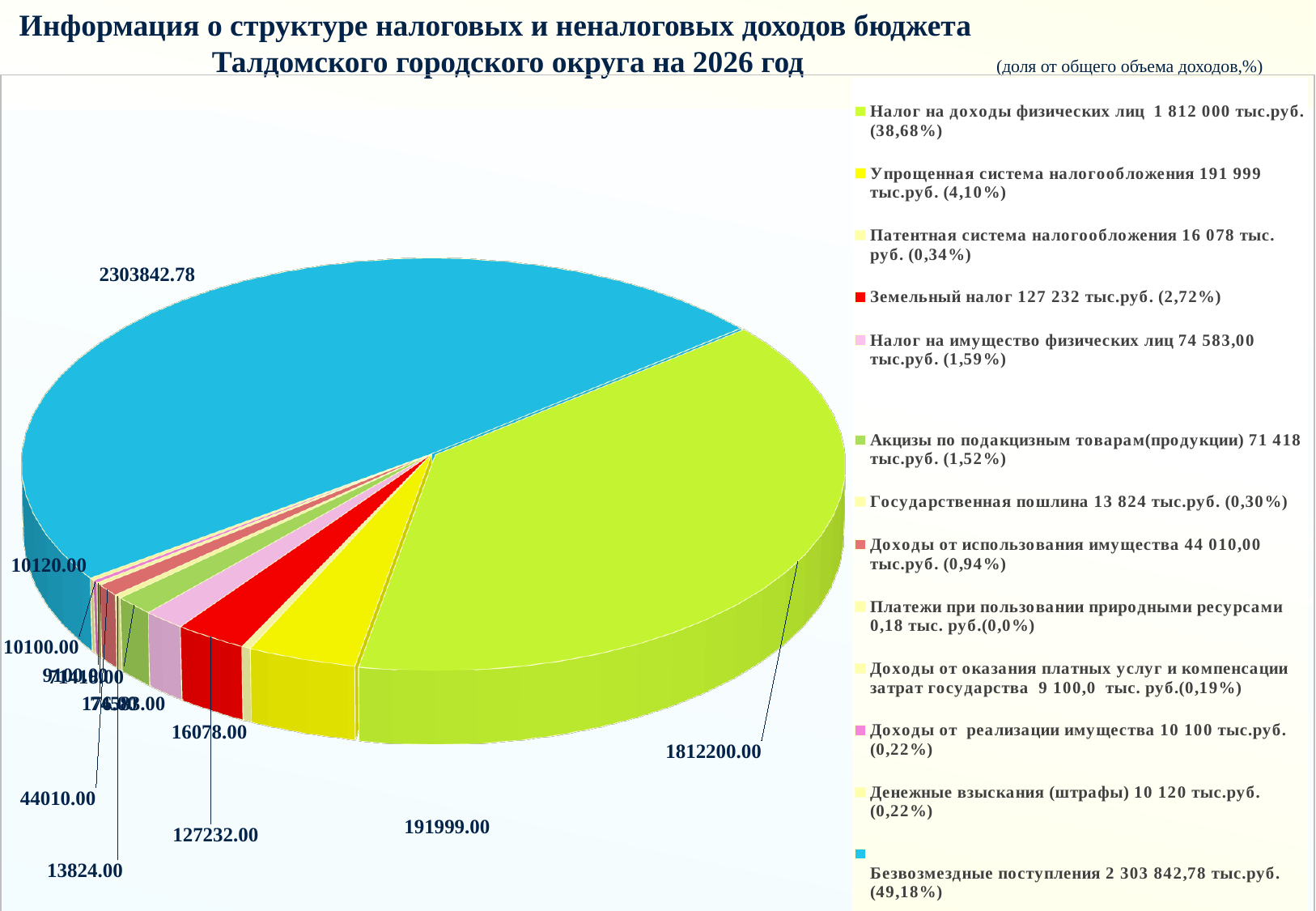
Which category has the largest share of the pie? Безвозмездные поступления Which category has the smallest share according to the legend? Платежи при пользовании природными ресурсами What share of total revenue does Налог на доходы физических лиц represent, according to the legend? 38,68% Which is larger: the slice for Упрощенная система налогообложения or the slice for Земельный налог? Упрощенная система налогообложения What is the data label shown on the slice for Упрощенная система налогообложения? 191999.00 What is the data label shown on the slice for Земельный налог? 127232.00 What is the data label shown on the slice for Безвозмездные поступления? 2303842.78 What kind of chart is shown on the slide? pie chart What share of total revenue does Земельный налог represent, according to the legend? 2,72% How many categories does the legend list? 13 What is the difference between the data labels for Безвозмездные поступления (2303842.78) and Налог на доходы физических лиц (1812200.00)? 491642.78 What is the data label shown on the slice for Государственная пошлина? 13824.00